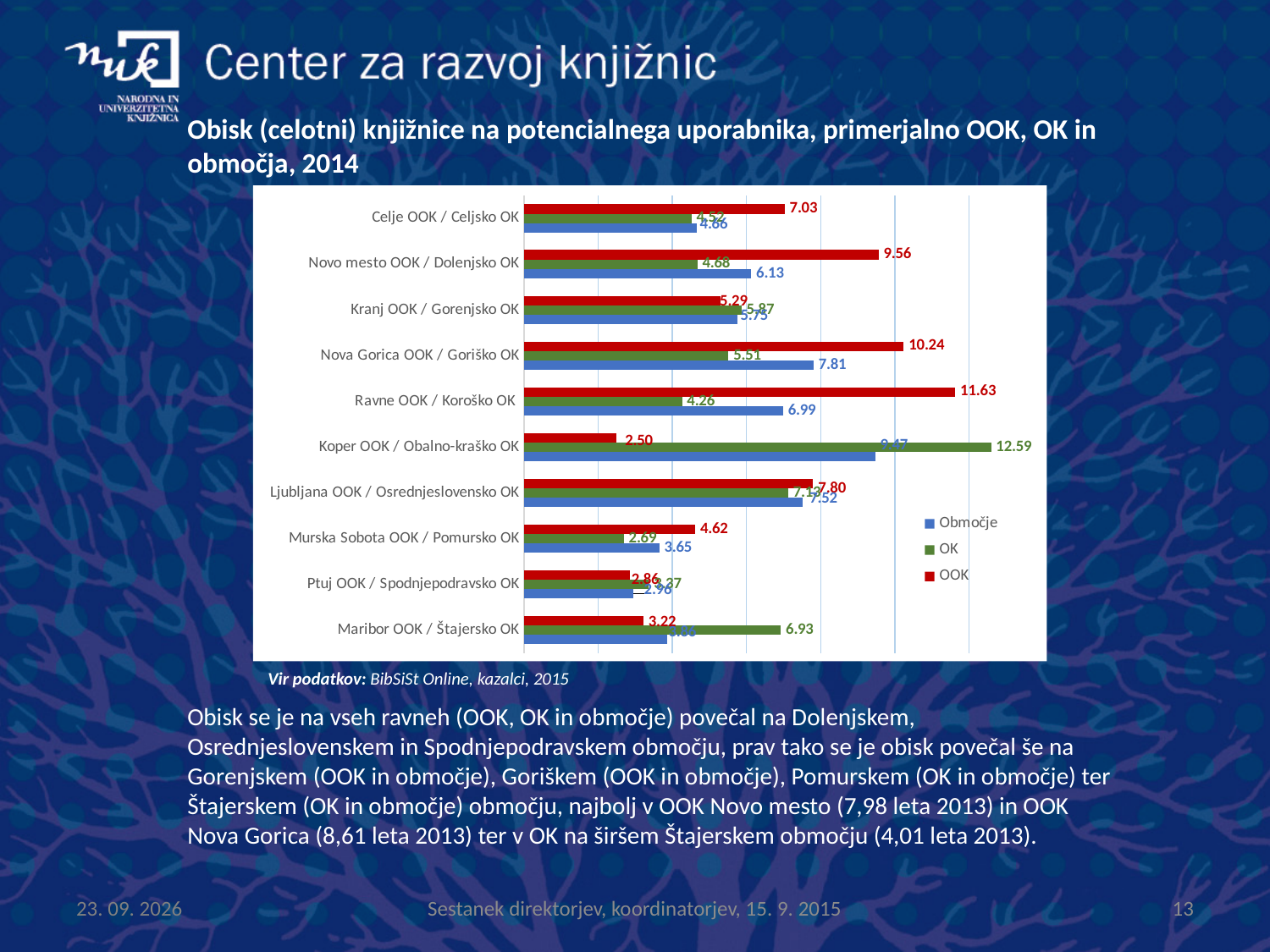
What is the OOK value for Ravne OOK / Koroško OK? 11.63 For Novo mesto OOK / Dolenjsko OK, what is the difference between the OOK value and the OK value? 4.88 What colour represents the OOK series in the chart? red What is the OK value for Koper OOK / Obalno-kraško OK? 12.59 What is the Območje value for Murska Sobota OOK / Pomursko OK? 3.65 Which category has the highest OOK value? Ravne OOK / Koroško OK How many series does the chart legend list? 3 How many categories (library pairs) are shown on the chart? 10 For Maribor OOK / Štajersko OK, which is larger: the OK value or the OOK value? OK What is the Območje value for Nova Gorica OOK / Goriško OK? 7.81 What kind of chart is shown on the slide? bar chart Which category has the lowest OOK value? Koper OOK / Obalno-kraško OK